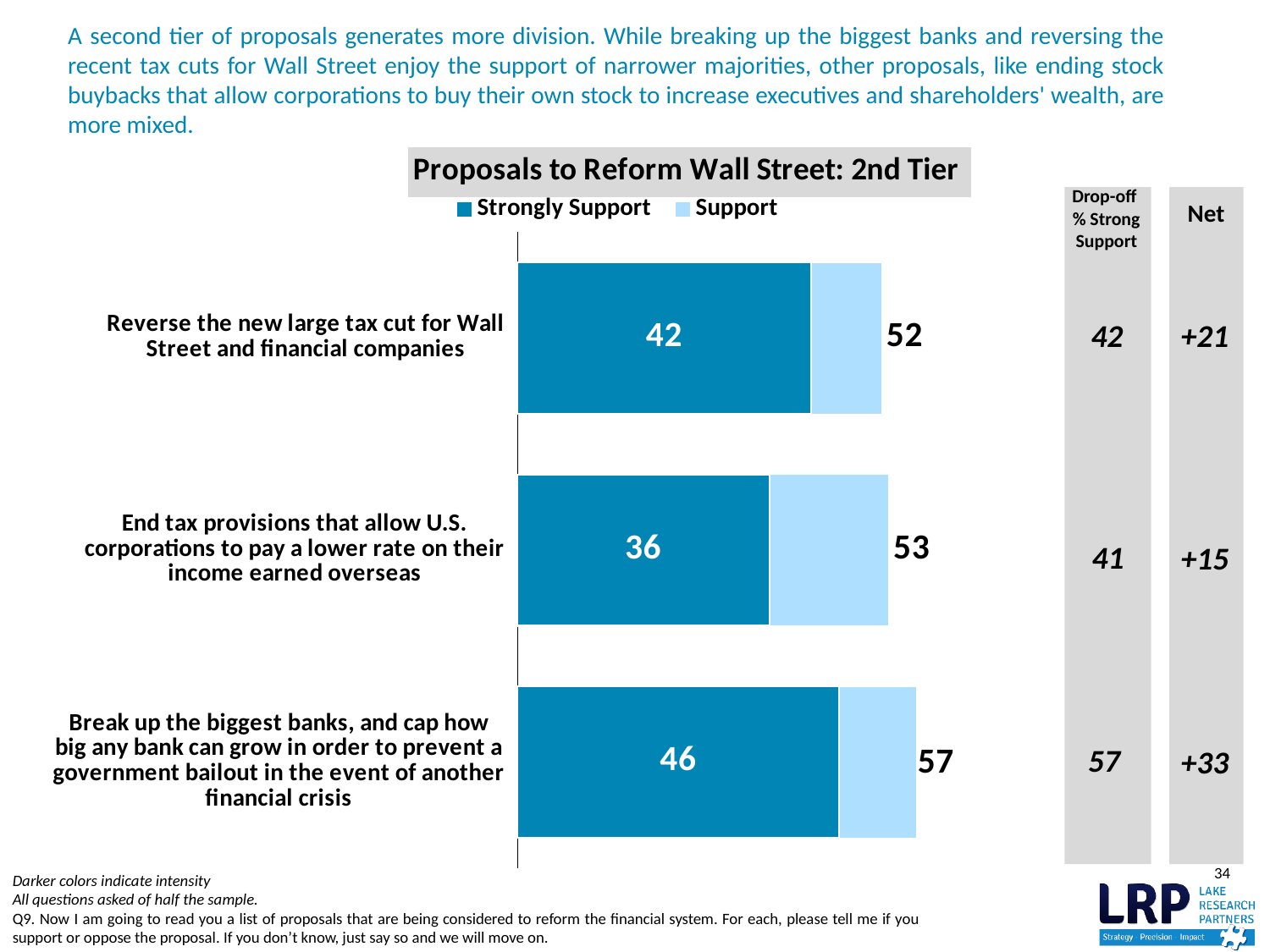
What is the title of the chart? Proposals to Reform Wall Street: 2nd Tier How many series does the legend list? 2 How many proposals are plotted in the chart? 3 What is the total support shown for "End tax provisions that allow U.S. corporations to pay a lower rate on their income earned overseas"? 53 Which proposal has the highest Strongly Support value? Break up the biggest banks, and cap how big any bank can grow in order to prevent a government bailout in the event of another financial crisis What is the Strongly Support value for "Reverse the new large tax cut for Wall Street and financial companies"? 42 Which proposal has the lowest Strongly Support value? End tax provisions that allow U.S. corporations to pay a lower rate on their income earned overseas What type of chart is shown on the slide? Stacked bar chart What is the Strongly Support value for "End tax provisions that allow U.S. corporations to pay a lower rate on their income earned overseas"? 36 Which has a larger Strongly Support value: reversing the tax cut for Wall Street or ending tax provisions on overseas income? Reverse the new large tax cut for Wall Street and financial companies What is the difference between the total support for breaking up the biggest banks (57) and the total support for reversing the tax cut for Wall Street (52)? 5 What is the total support (Strongly Support plus Support) shown for "Break up the biggest banks, and cap how big any bank can grow in order to prevent a government bailout in the event of another financial crisis"? 57